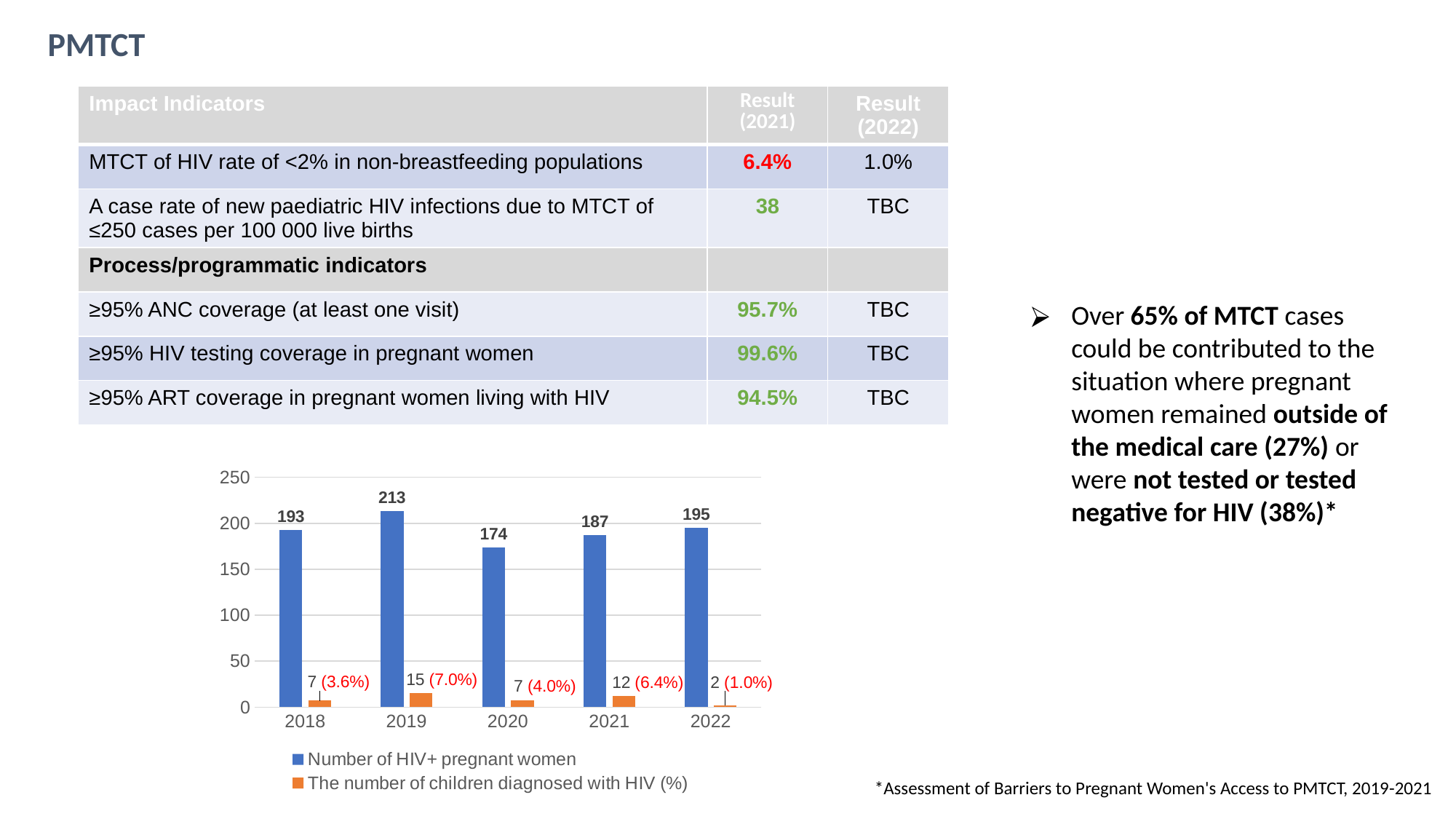
Which is larger, the number of HIV+ pregnant women in 2018 or in 2022? 2022 How many years are shown on the x axis of the chart? 5 What is the number of HIV+ pregnant women in 2019? 213 What kind of chart is shown on the slide? bar chart How many series does the chart legend list? 2 Is the number of HIV+ pregnant women in 2021 greater or less than 150? greater Which year has the lowest number of HIV+ pregnant women? 2020 What is the difference between the number of HIV+ pregnant women in 2019 and 2020? 39 Which year has the highest number of HIV+ pregnant women? 2019 What colour are the bars for the number of HIV+ pregnant women? blue What is the number of children diagnosed with HIV in 2021? 12 (6.4%) Which year has the lowest number of children diagnosed with HIV? 2022